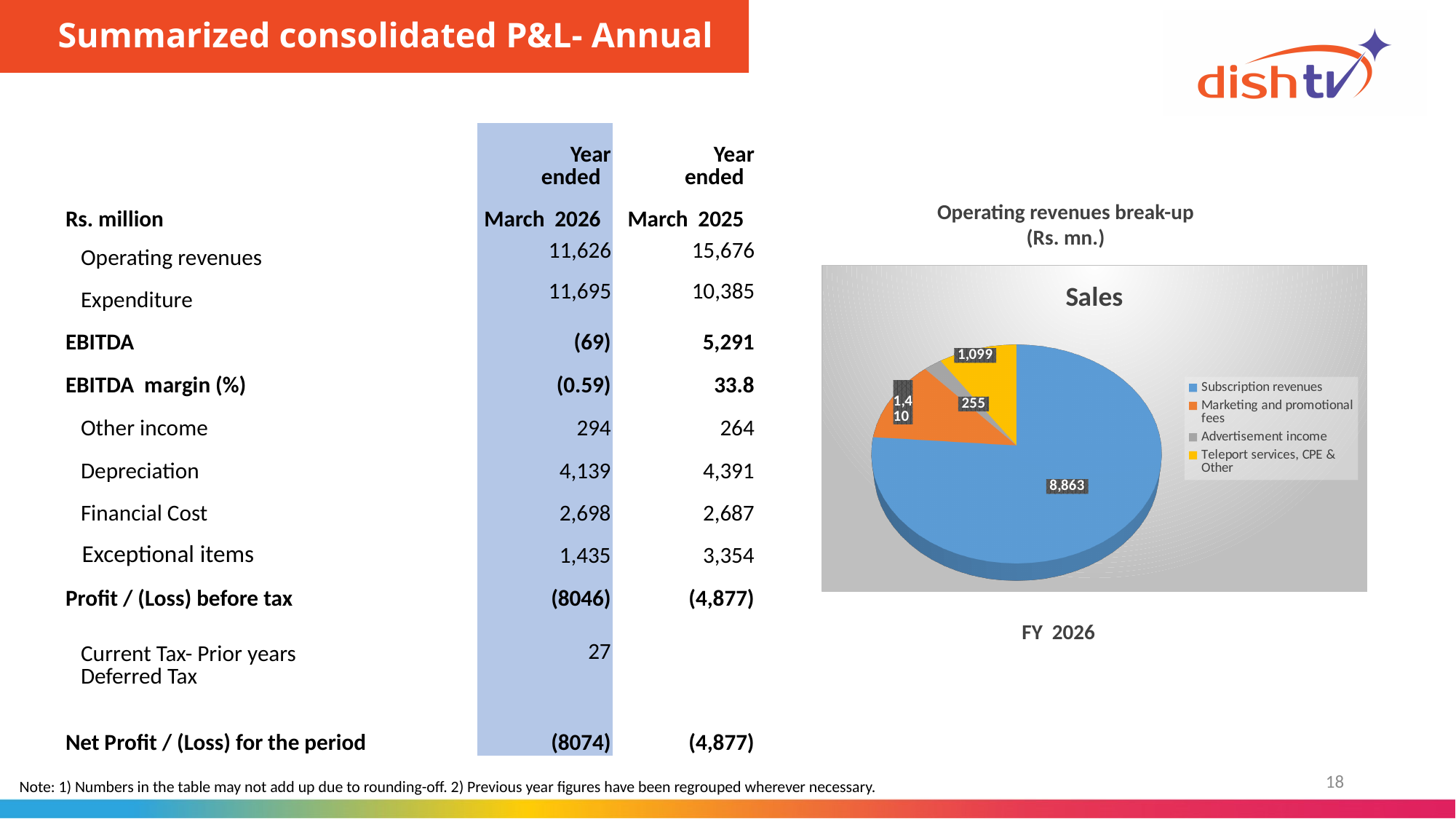
In the operating revenues break-up pie chart, what is the value for Advertisement income? 255 In the operating revenues break-up pie chart, what is the difference between Subscription revenues and Marketing and promotional fees? 7,453 What colour represents Subscription revenues in the operating revenues break-up pie chart? Blue How many entries does the legend of the operating revenues break-up pie chart list? 4 How many slices does the operating revenues break-up pie chart have? 4 In the operating revenues break-up pie chart, what is the value for Subscription revenues? 8,863 Which category has the largest slice in the operating revenues break-up pie chart? Subscription revenues In the operating revenues break-up pie chart, what is the value for Teleport services, CPE & Other? 1,099 In the operating revenues break-up pie chart, which is larger: Marketing and promotional fees or Teleport services, CPE & Other? Marketing and promotional fees What type of chart is used to show the operating revenues break-up? Pie chart Which category has the smallest slice in the operating revenues break-up pie chart? Advertisement income In the operating revenues break-up pie chart, what is the value for Marketing and promotional fees? 1,410